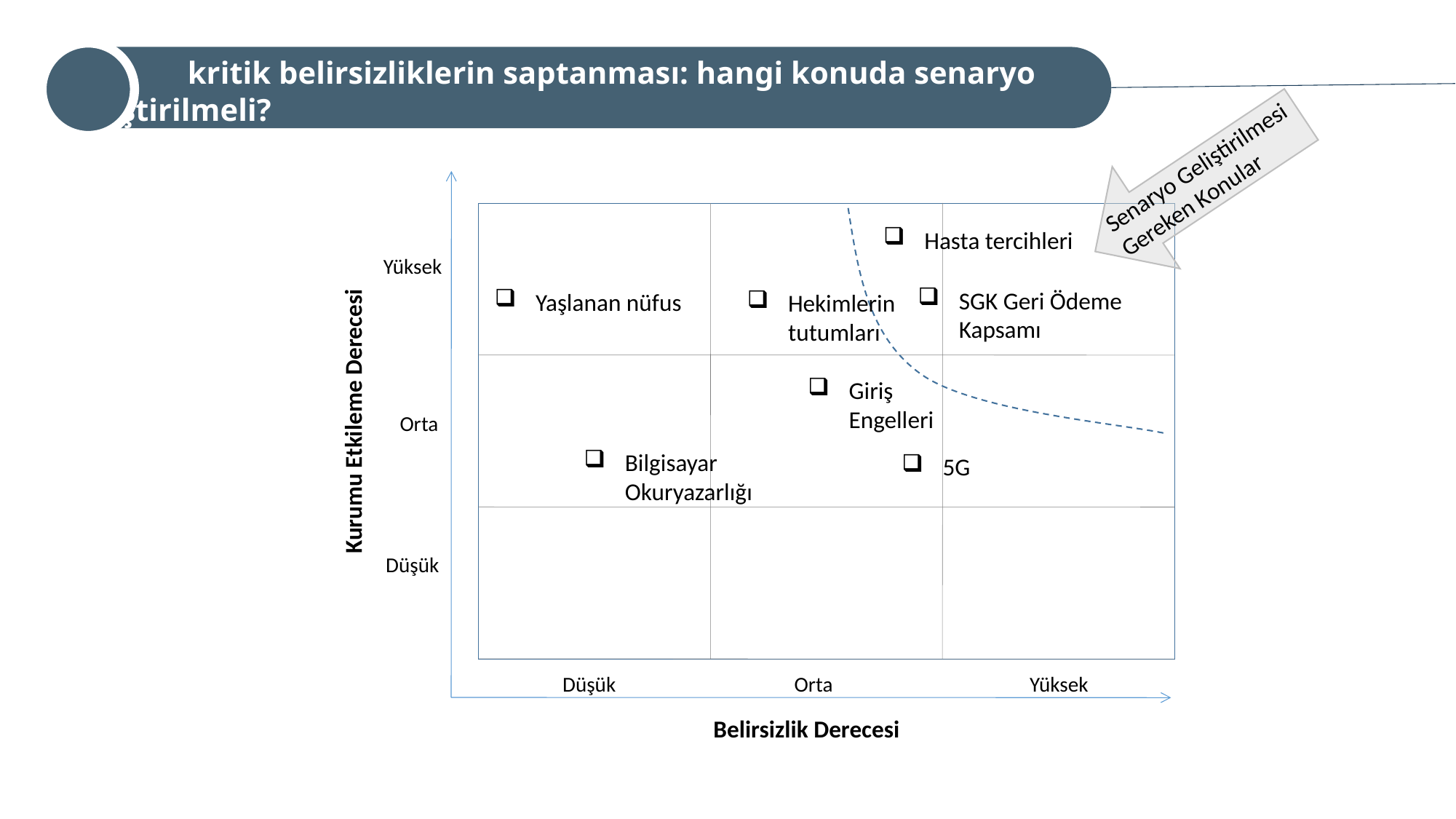
In which row of Kurumu Etkileme Derecesi is 'Bilgisayar Okuryazarlığı' placed? Orta Which row of Kurumu Etkileme Derecesi contains no topics? Düşük Which has the higher Belirsizlik Derecesi, 'Bilgisayar Okuryazarlığı' or '5G'? 5G What is the label of the horizontal axis of the matrix? Belirsizlik Derecesi In which column of Belirsizlik Derecesi is 'Yaşlanan nüfus' placed? Düşük In which row of Kurumu Etkileme Derecesi is 'Yaşlanan nüfus' placed? Yüksek How many levels does the horizontal axis (Belirsizlik Derecesi) show? 3 What is the label of the vertical axis of the matrix? Kurumu Etkileme Derecesi In which row of Kurumu Etkileme Derecesi is 'Hasta tercihleri' placed? Yüksek In which row of Kurumu Etkileme Derecesi is '5G' placed? Orta Which has the higher Kurumu Etkileme Derecesi, 'Hekimlerin tutumları' or 'Giriş Engelleri'? Hekimlerin tutumları How many topics are plotted in the matrix? 7